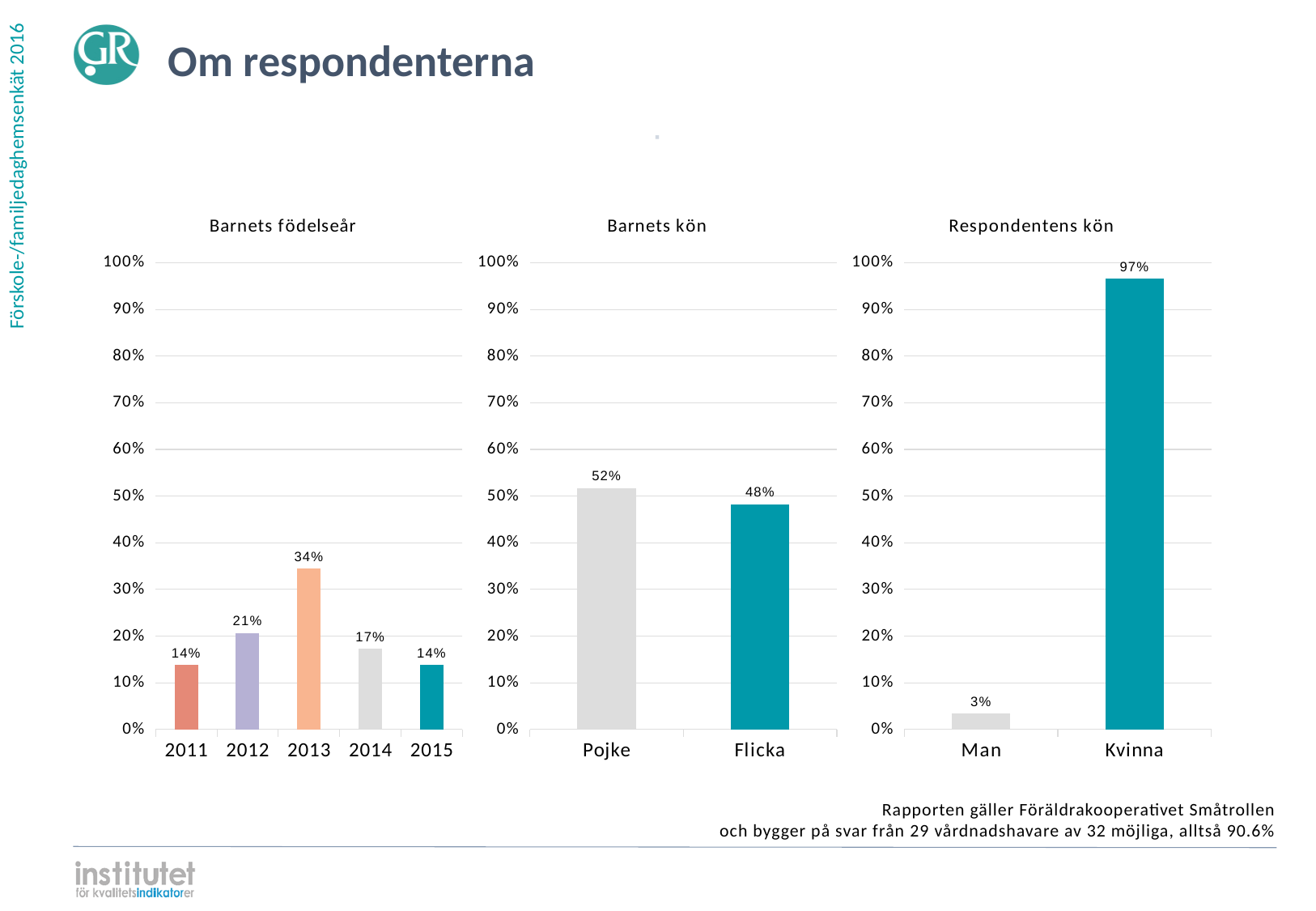
What is the title of the chart on the left of the slide? Barnets födelseår In the 'Barnets födelseår' chart, is the value for 2014 greater or less than 20%? less In the 'Respondentens kön' chart, which category has the lowest value? Man In the 'Barnets födelseår' chart, what is the difference between the values for 2013 and 2012? 13% What kind of chart is the 'Respondentens kön' chart? Bar chart In the 'Barnets kön' chart, what is the difference between Pojke and Flicka? 4% In the 'Barnets födelseår' chart, how many birth-year categories are shown? 5 In the 'Barnets födelseår' chart, what is the value for 2013? 34% In the 'Barnets födelseår' chart, which birth year has the highest value? 2013 In the 'Barnets kön' chart, which is larger, Pojke or Flicka? Pojke In the 'Respondentens kön' chart, what is the value for Kvinna? 97% In the 'Barnets kön' chart, what is the value for Pojke? 52%